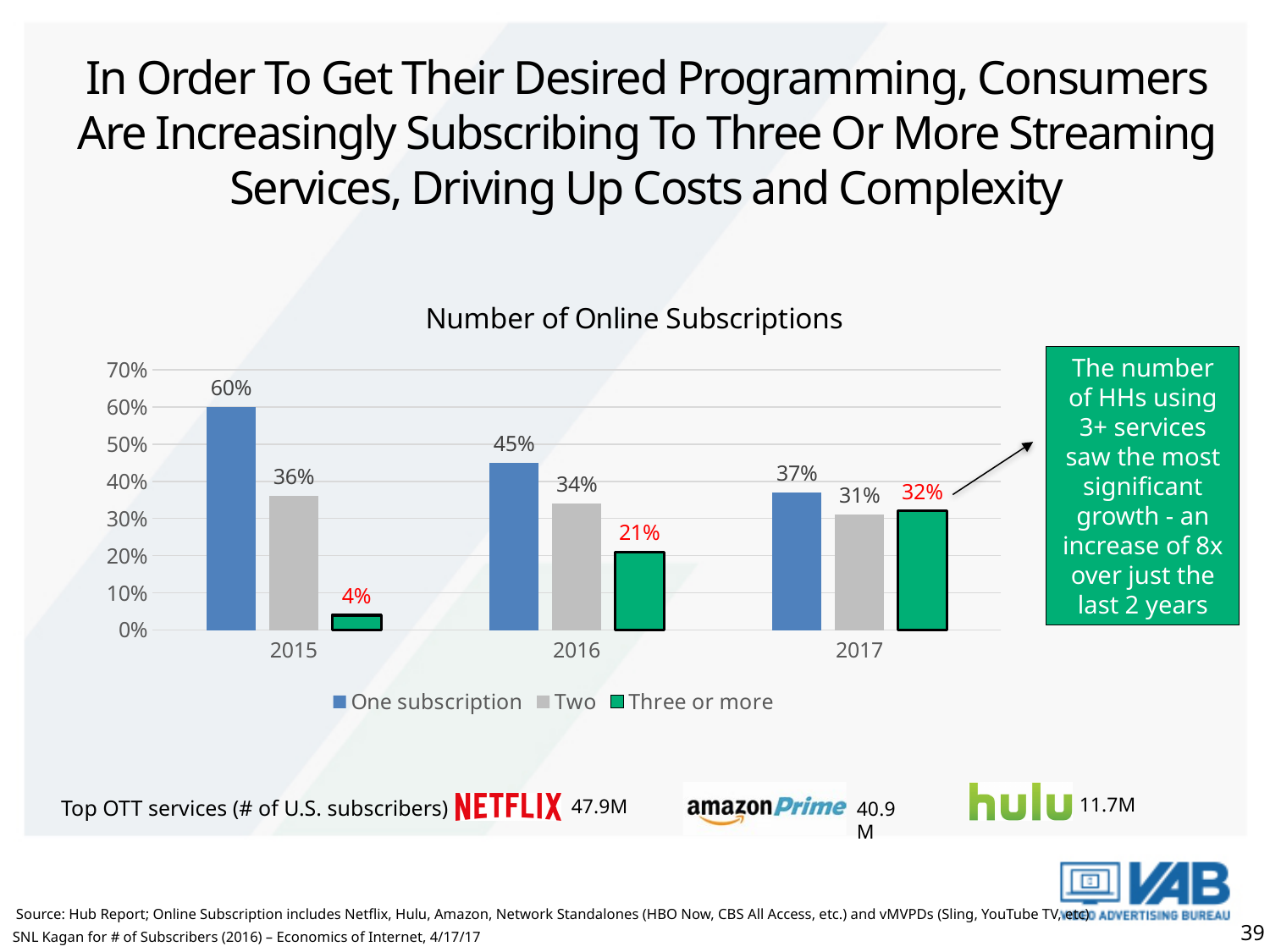
Which year has the highest value for Three or more? 2017 Is the value for Three or more in 2016 greater or less than 30%? less How many series does the legend list? 3 What is the value for Two in 2016? 34% Which year has the lowest value for One subscription? 2017 What is the difference between the One subscription value in 2015 and in 2017? 23% What kind of chart is shown? bar chart What is the value for Three or more in 2017? 32% Which is larger in 2017: the value for Two or the value for Three or more? Three or more What is the value for One subscription in 2015? 60% How many years are shown on the x axis? 3 Does the value for One subscription rise or fall from 2015 to 2017? fall